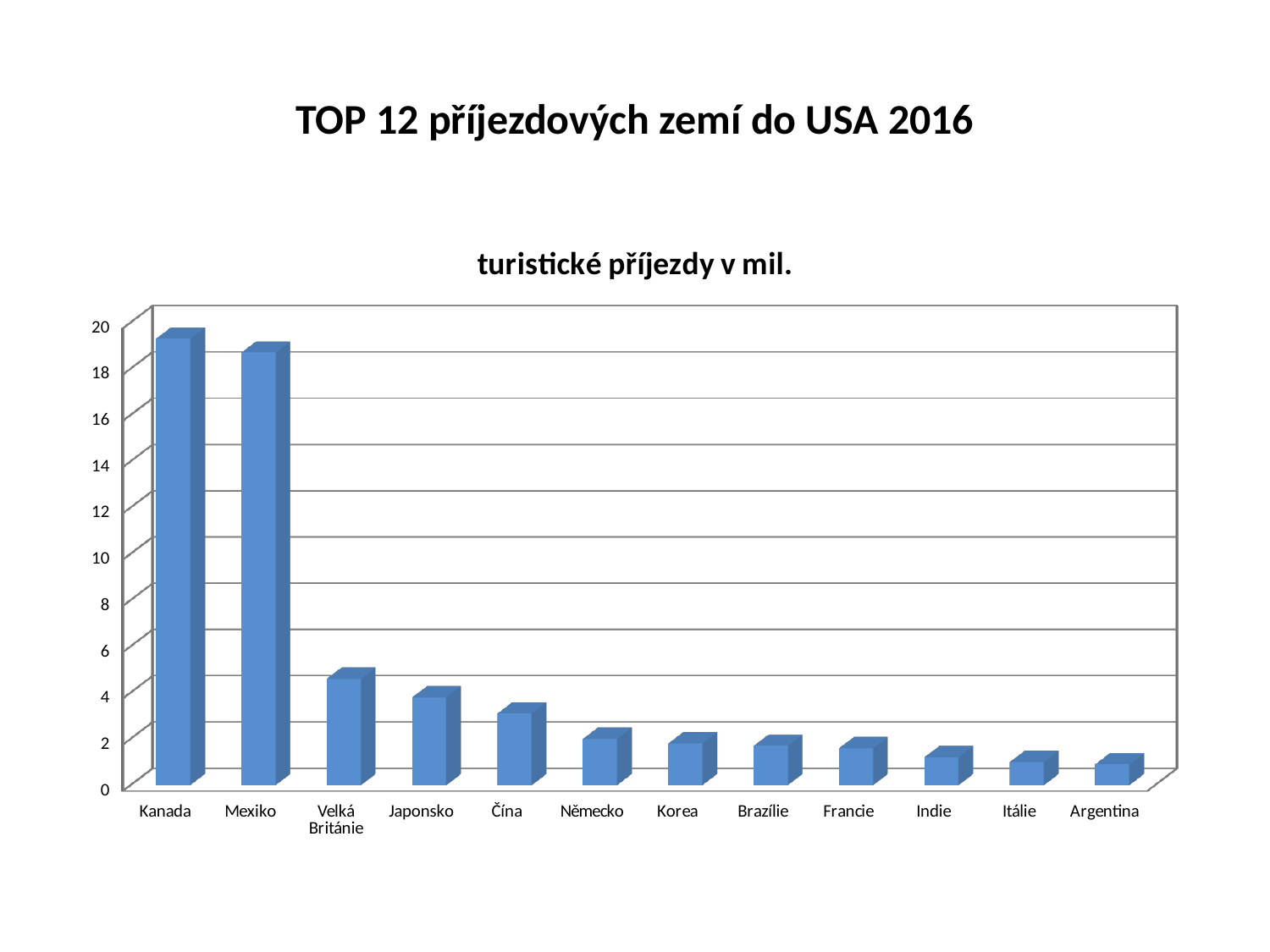
What is the title of the chart? turistické příjezdy v mil. Is the value for Indie greater or less than 2? less Is the value for Kanada greater or less than 18? greater Which has a larger value, Velká Británie or Japonsko? Velká Británie Which has a larger value, Čína or Německo? Čína Which country has the highest value in the chart? Kanada What type of chart is shown on the slide? bar chart Is the value for Mexiko greater or less than 16? greater How many countries are shown on the x axis of the chart? 12 Do the values rise or fall moving from left to right along the x axis? fall